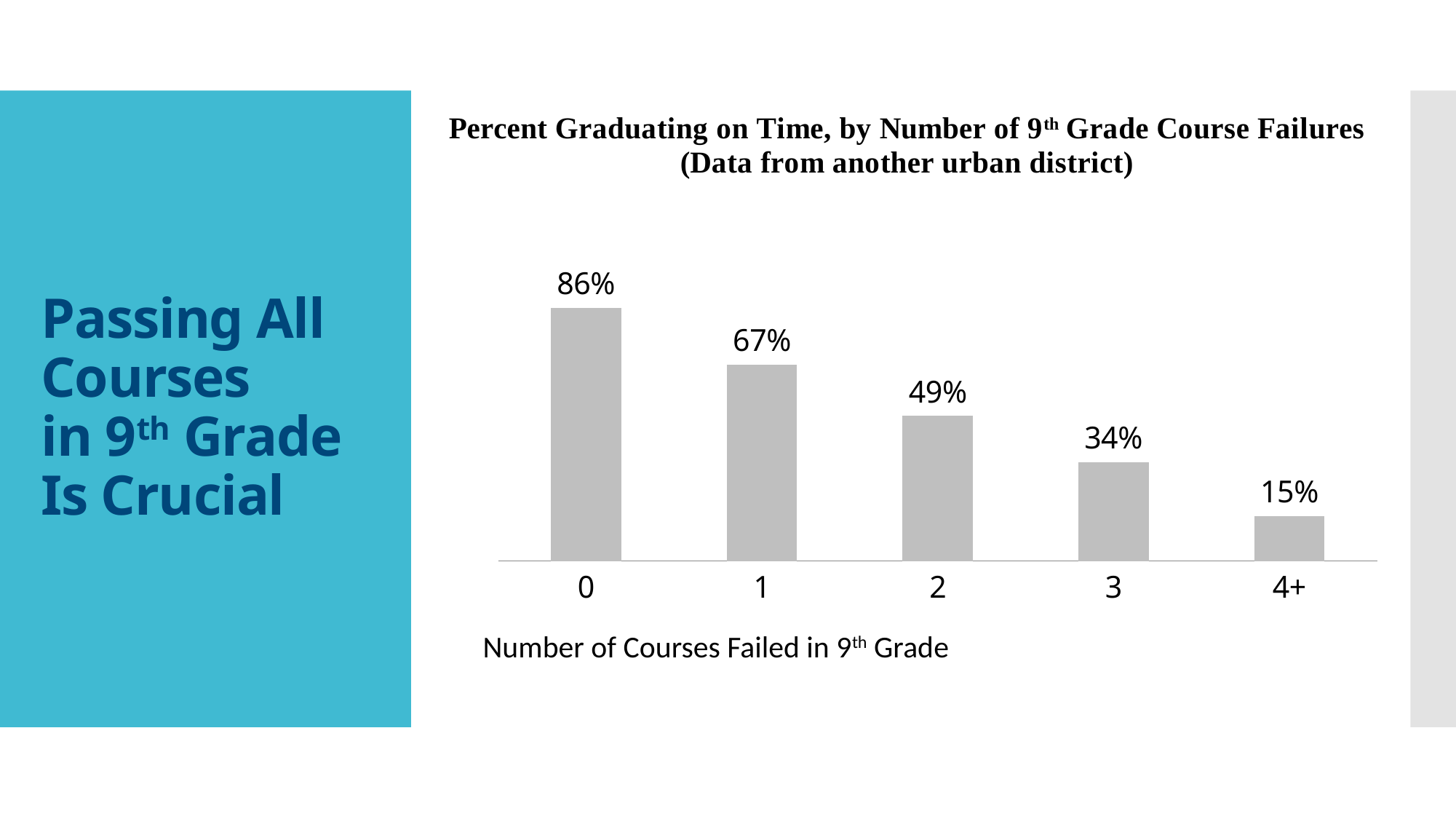
What is the x-axis label of the chart? Number of Courses Failed in 9th Grade What is the value shown for students who failed 2 courses in 9th grade? 49% Which is larger: the value for 1 course failed or the value for 3 courses failed? 1 course failed What is the difference in percent graduating on time between students with 0 failures and students with 1 failure? 19% What percent of students with 0 course failures in 9th grade graduated on time? 86% Do the values rise or fall as the number of courses failed increases along the x axis? Fall Which number of courses failed has the highest percent graduating on time? 0 Which category has the lowest percent graduating on time? 4+ What percent graduated on time among students with 4+ course failures? 15% What kind of chart is shown on the slide? Bar chart How many categories are shown on the x axis of the chart? 5 What is the difference between the values for 3 course failures and 4+ course failures? 19%